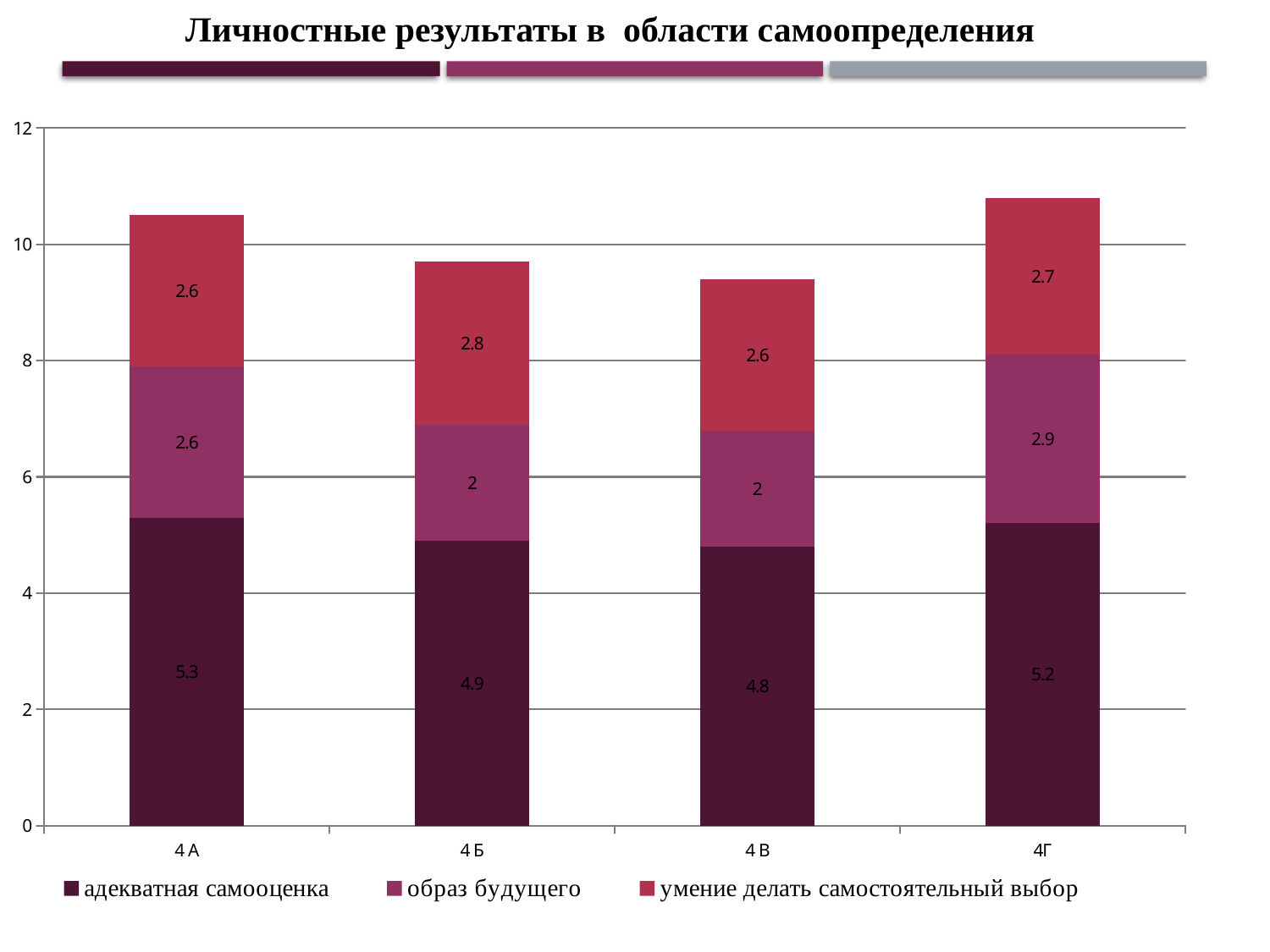
What is the value of 'образ будущего' for 4Г? 2.9 Which category has the highest value for 'адекватная самооценка'? 4 А What type of chart is shown on the slide? stacked bar chart What is the difference between the 'адекватная самооценка' values for 4 А and 4 В? 0.5 What is the total of the stacked bar for 4 В? 9.4 How many categories are shown on the x axis? 4 Which category has the lowest value for 'адекватная самооценка'? 4 В How many series does the legend list? 3 What is the value of 'адекватная самооценка' for 4 А? 5.3 Which is larger: 'образ будущего' for 4 А or for 4 Б? 4 А What is the total of the stacked bar for 4Г? 10.8 What is the value of 'умение делать самостоятельный выбор' for 4 Б? 2.8